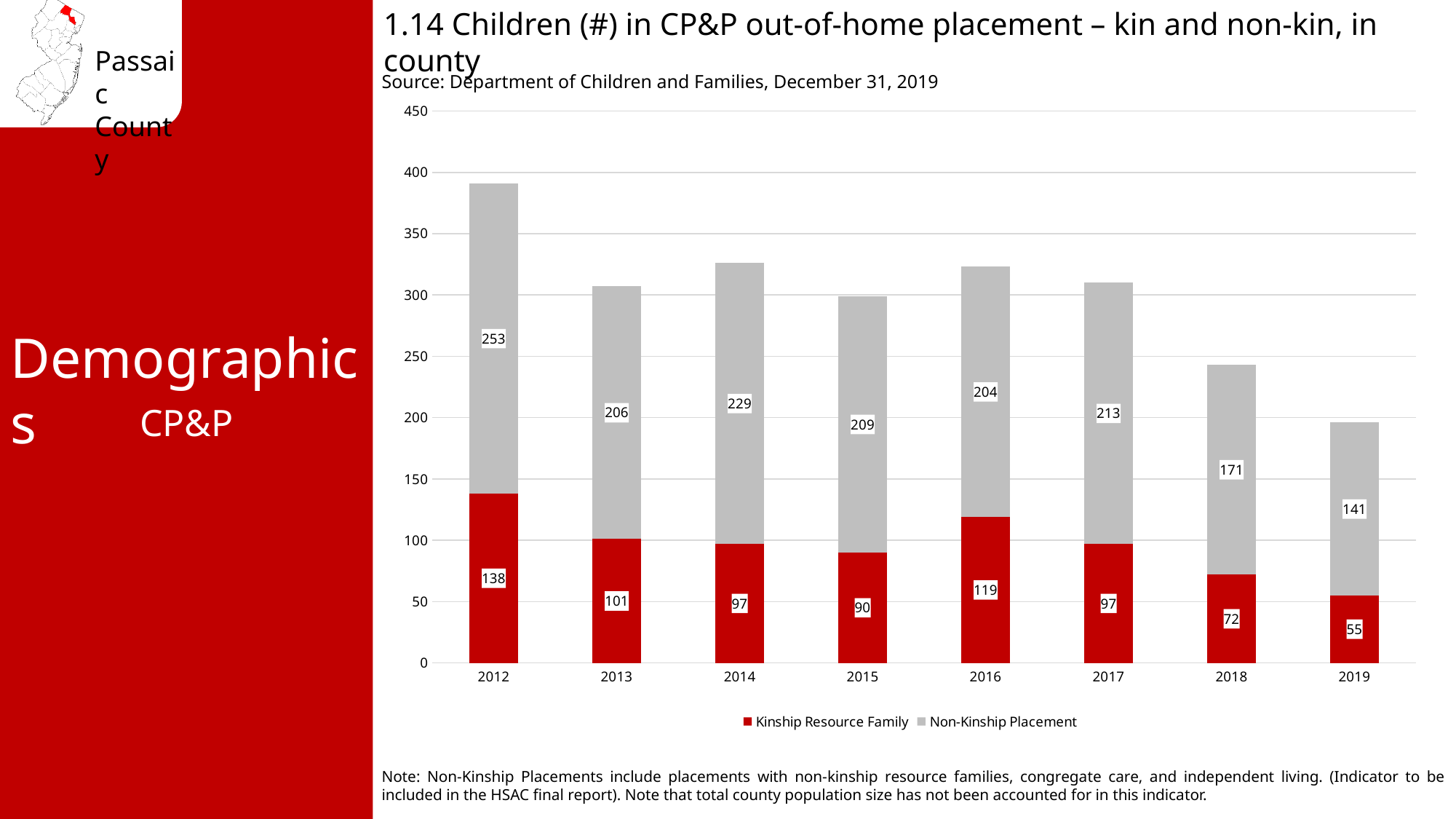
How many series does the legend list? 2 Which is larger, the Kinship Resource Family value for 2016 or for 2017? 2016 What is the Kinship Resource Family value for 2012? 138 What is the Non-Kinship Placement value for 2019? 141 What is the total of the stacked bar for 2018? 243 Which year has the lowest Non-Kinship Placement value? 2019 What is the total of the stacked bar for 2019? 196 What is the Non-Kinship Placement value for 2016? 204 How many years are shown on the x axis? 8 What kind of chart is shown? Stacked bar chart What is the difference between the Non-Kinship Placement values for 2012 and 2013? 47 Which year has the highest Kinship Resource Family value? 2012